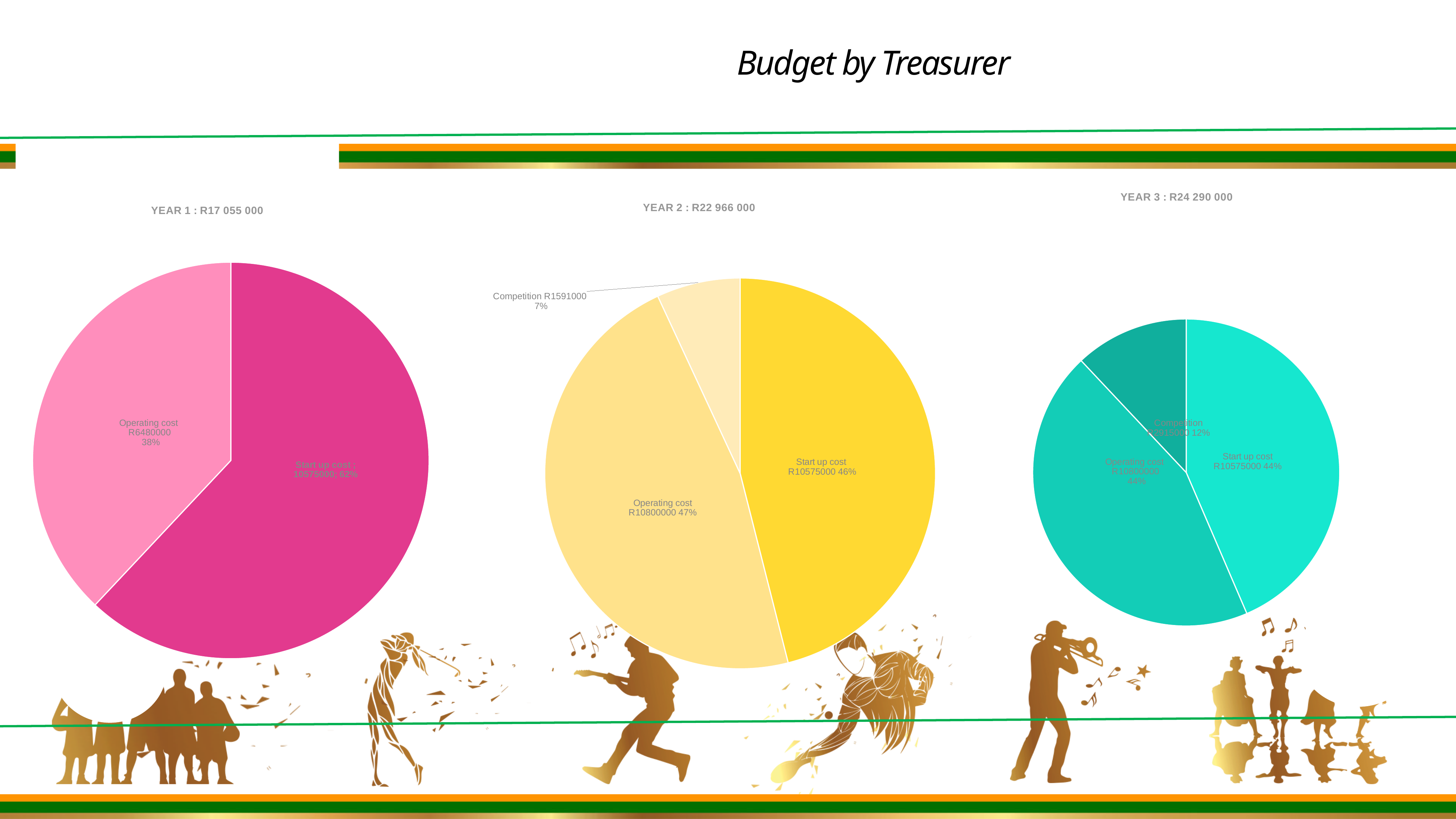
How many slices does the YEAR 2 chart have? 3 In the YEAR 1 chart, what share of the pie is Start up cost? 62% In the YEAR 3 chart, what share of the pie is Competition? 12% In the YEAR 3 chart, what is the value for Competition? R2915000 In the YEAR 2 chart, what is the value for Competition? R1591000 In the YEAR 2 chart, what share of the pie is Start up cost? 46% What is the title of the chart on the right of the slide? YEAR 3 : R24 290 000 In the YEAR 2 chart, which category has the largest share? Operating cost In the YEAR 2 chart, which category has the smallest share? Competition In the YEAR 1 chart, what is the value for Operating cost? R6480000 What kind of chart is the YEAR 1 chart? pie chart